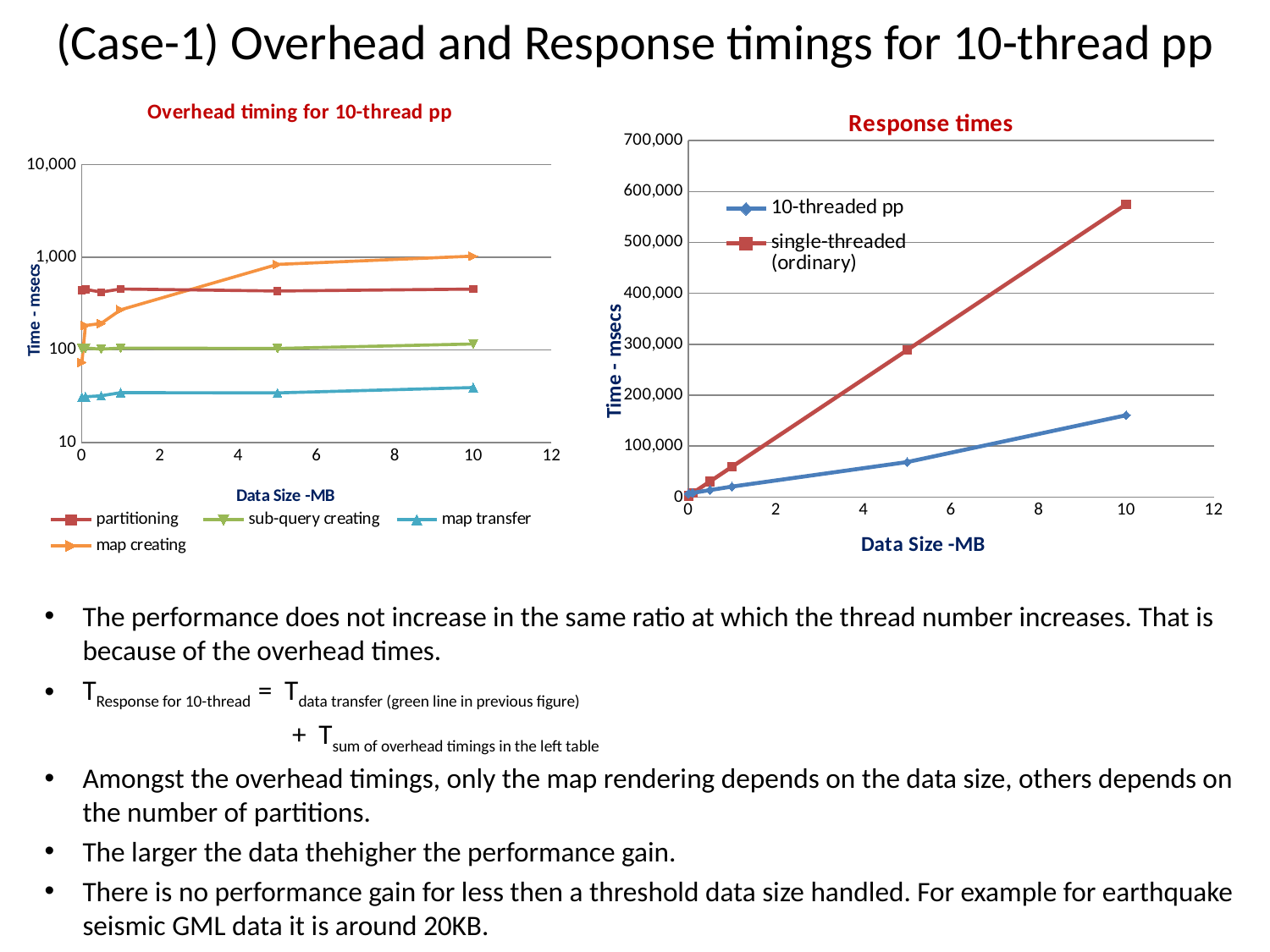
What type of chart is the 'Response times' chart? line chart What is the x-axis label of the 'Overhead timing for 10-thread pp' chart? Data Size -MB How many series does the legend of the 'Response times' chart list? 2 In the 'Overhead timing for 10-thread pp' chart, which series has the highest value at a data size of 10 MB? map creating How many series does the legend of the 'Overhead timing for 10-thread pp' chart list? 4 In the 'Response times' chart, is the value for 10-threaded pp at 10 MB greater or less than 200,000? less In the 'Response times' chart, is the value for single-threaded (ordinary) at 10 MB greater or less than 500,000? greater In the 'Overhead timing for 10-thread pp' chart, which series has the lowest value at a data size of 10 MB? map transfer In the 'Response times' chart, which series has the higher value at a data size of 10 MB? single-threaded (ordinary) In the 'Response times' chart, is the value for single-threaded (ordinary) at 5 MB greater or less than 200,000? greater In the 'Response times' chart, do the values for single-threaded (ordinary) rise or fall as data size increases? rise